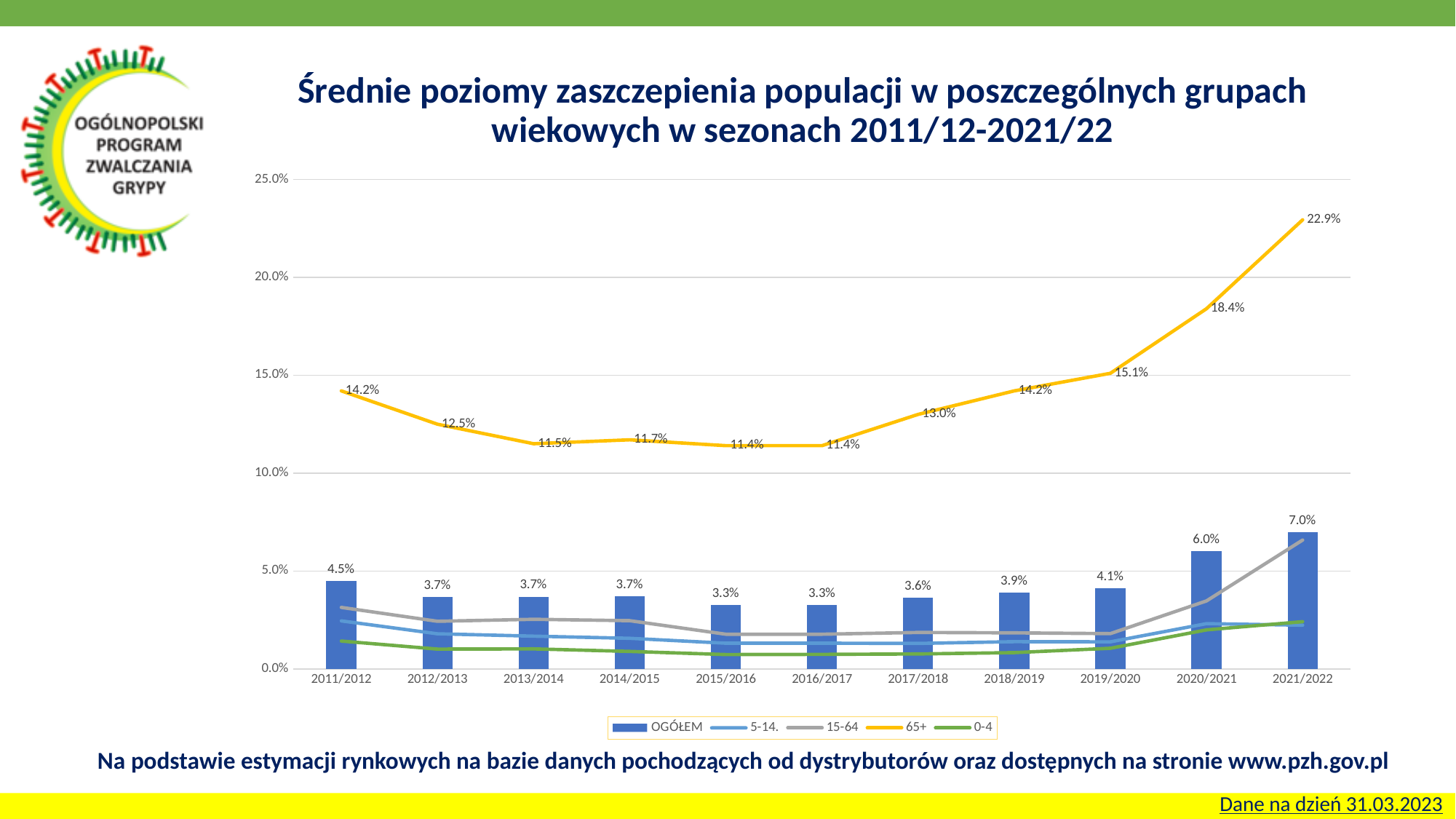
How many series does the legend list? 5 What is the value for the 65+ group in the 2011/2012 season? 14.2% What is the OGÓŁEM value for the 2021/2022 season? 7.0% In which season is the OGÓŁEM value lowest? 2015/2016 and 2016/2017 What kind of chart is shown on the slide? Combined bar and line chart What is the difference between the 65+ value in 2021/2022 and in 2020/2021? 4.5% In which season is the 65+ value highest? 2021/2022 Is the value for the 15-64 group in 2021/2022 greater or less than 5.0%? greater How many seasons are shown on the x axis? 11 Does the 65+ value rise or fall from 2016/2017 to 2021/2022? rise What is the value for the 65+ group in the 2020/2021 season? 18.4% Which is larger: the OGÓŁEM value in 2011/2012 or in 2019/2020? 2011/2012